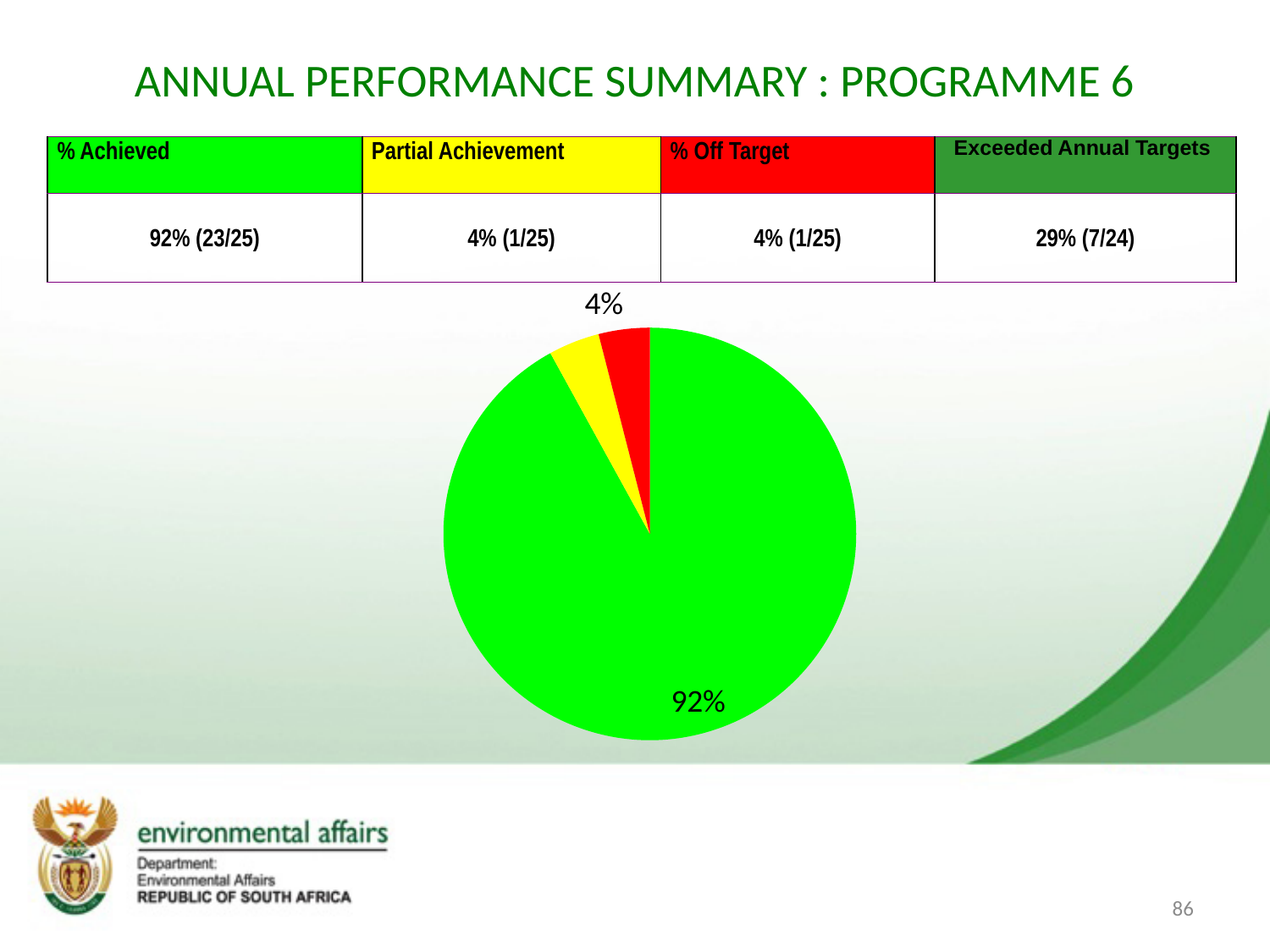
What is the title of the slide containing the pie chart? ANNUAL PERFORMANCE SUMMARY : PROGRAMME 6 What share of the pie does the % Off Target (red) slice represent? 4% Which is larger in the pie chart, the green slice or the yellow slice? the green slice What colour is the largest slice of the pie chart? green Which category has the largest slice in the pie chart? % Achieved What share of the pie does the % Achieved (green) slice represent? 92% What percentage is shown on the large green slice of the pie chart? 92% How many slices does the pie chart have? 3 What is the difference in percentage points between the % Achieved slice and the Partial Achievement slice? 88 Is the share of the green slice greater or less than 50%? greater What kind of chart is shown on the slide? pie chart What share of the pie does the Partial Achievement (yellow) slice represent? 4%